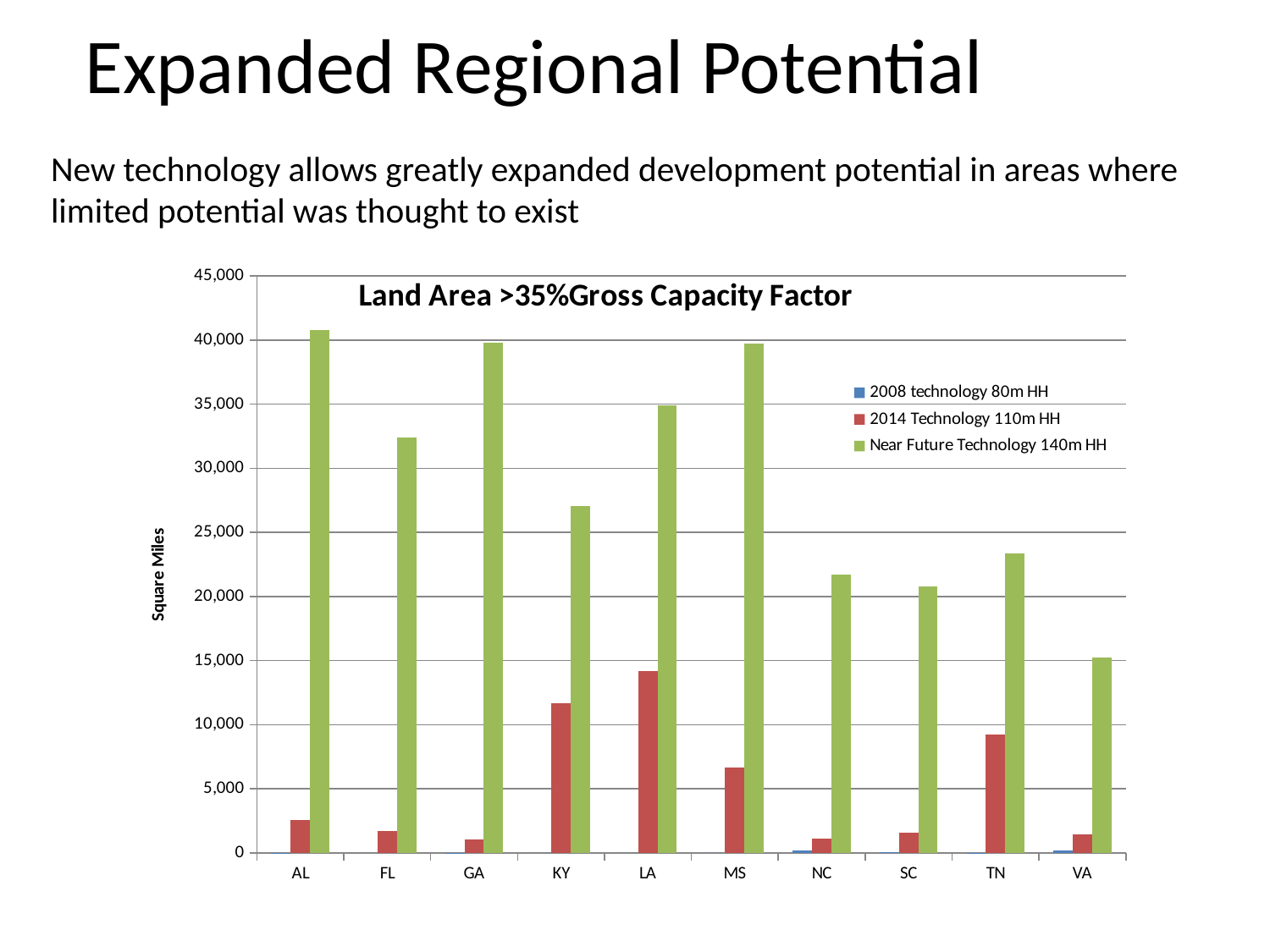
What kind of chart is shown on the slide? bar chart Which is larger, the 2014 Technology 110m HH value for KY or for TN? KY Is the 2014 Technology 110m HH value for TN greater or less than 10,000? less Is the Near Future Technology 140m HH value for KY greater or less than 25,000? greater Which is larger, the Near Future Technology 140m HH value for FL or for LA? LA How many states are shown on the x axis? 10 Which state has the lowest value for Near Future Technology 140m HH? VA Is the Near Future Technology 140m HH value for VA greater or less than 20,000? less How many series does the legend list? 3 Which state has the highest value for 2014 Technology 110m HH? LA What is the label on the y axis of the chart? Square Miles